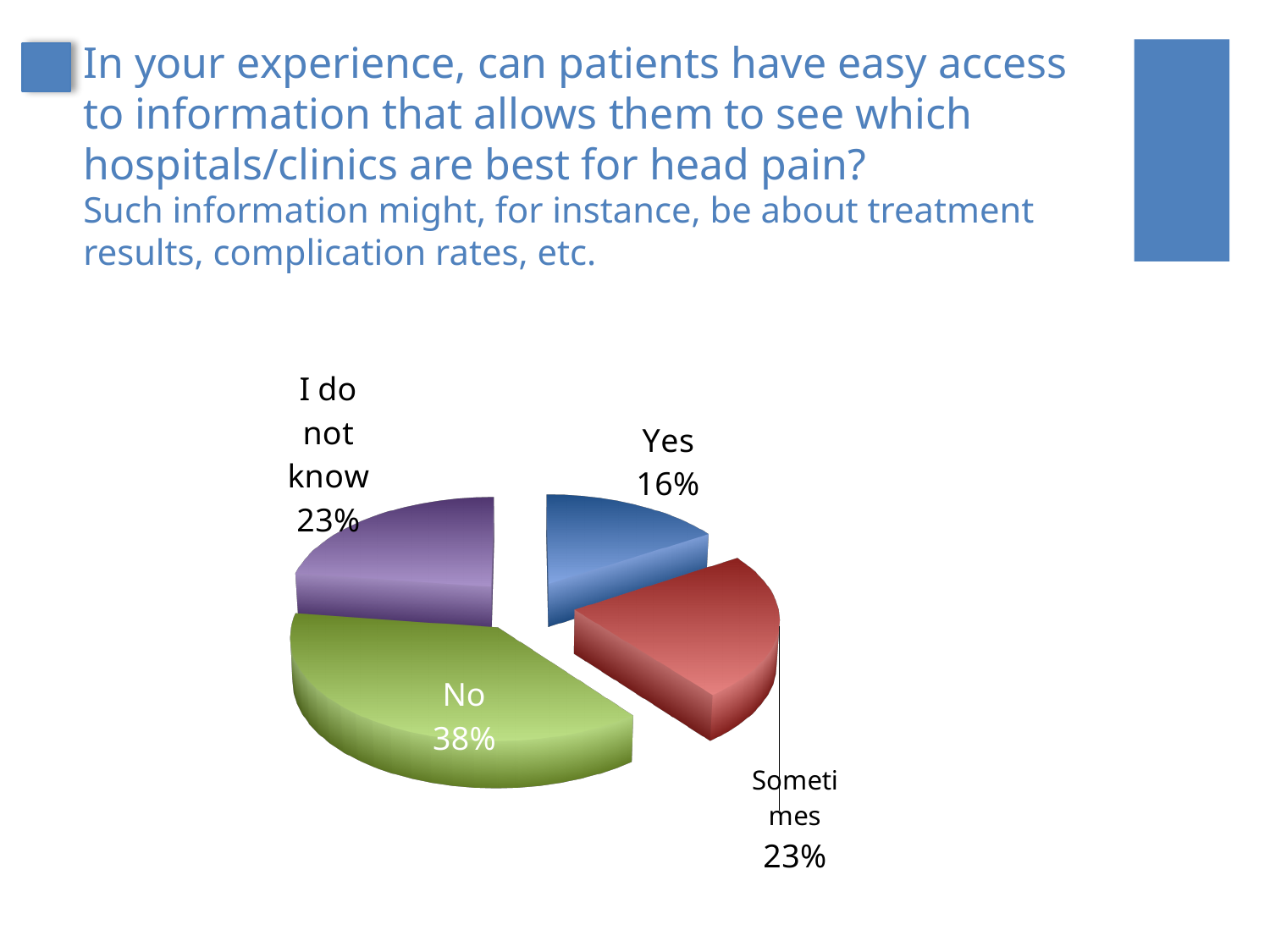
Which response has the smallest share of the pie? Yes What share of the pie does the "Yes" slice represent? 16% What share of the pie does the "Sometimes" slice represent? 23% How many slices does the pie chart have? 4 Which response has the largest share of the pie? No What is the difference in percentage points between the "No" and "Yes" slices? 22 What kind of chart is shown on the slide? Pie chart What colour is the "Yes" slice of the pie? Blue Which is larger, the "No" slice or the "Sometimes" slice? No What colour is the "No" slice of the pie? Green What share of the pie does the "No" slice represent? 38%